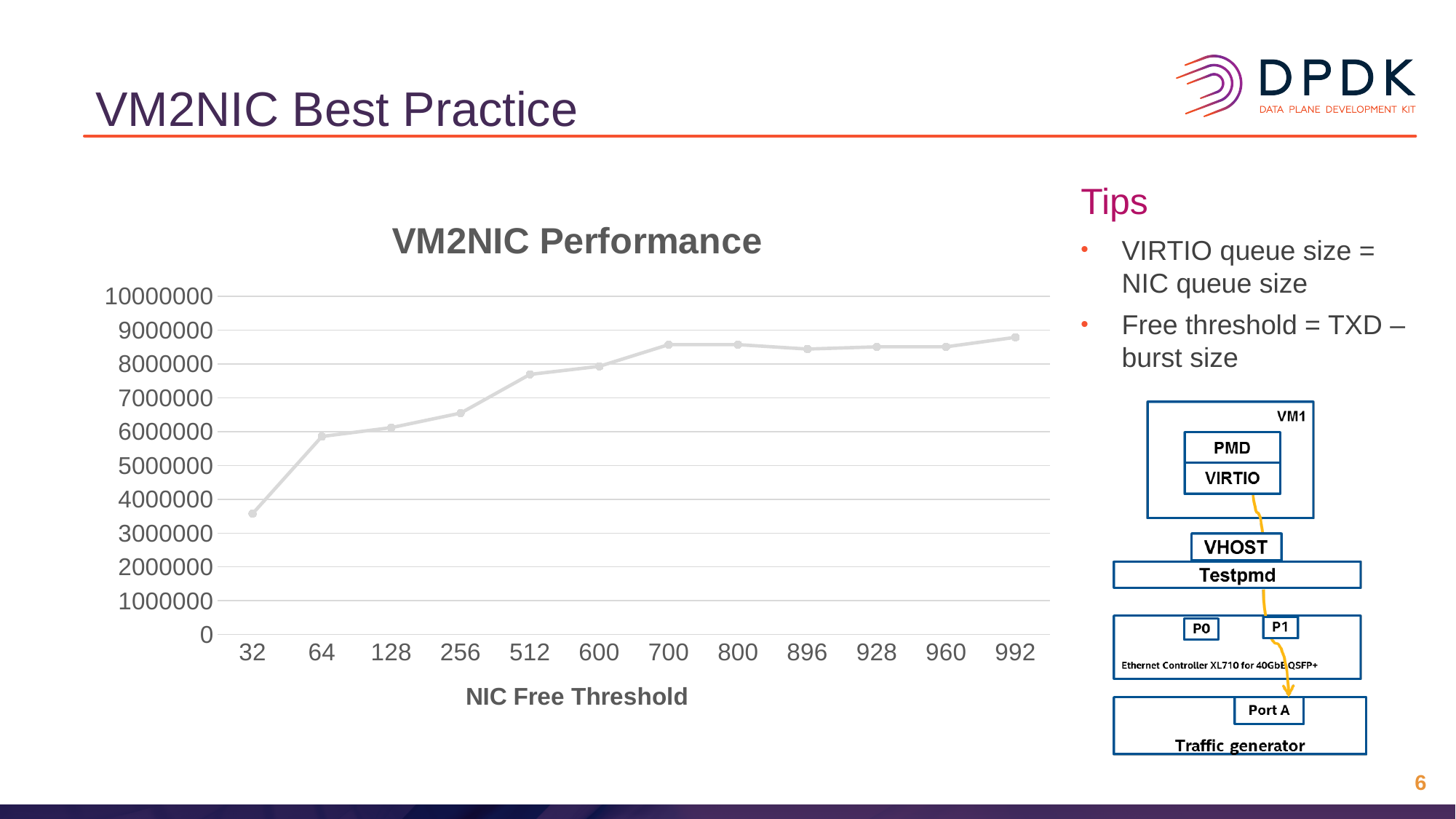
What is the title of the chart? VM2NIC Performance What kind of chart is shown on the slide? line chart How many NIC Free Threshold values are plotted on the x axis? 12 What is the x-axis title of the chart? NIC Free Threshold Which has the larger value, NIC Free Threshold 64 or NIC Free Threshold 32? 64 Is the value for NIC Free Threshold 512 greater or less than 7000000? greater Is the value for NIC Free Threshold 992 greater or less than 9000000? less Which NIC Free Threshold has the lowest performance value? 32 Is the value for NIC Free Threshold 32 greater or less than 4000000? less Which NIC Free Threshold has the highest performance value? 992 Do the values generally rise or fall as the NIC Free Threshold increases along the x axis? rise